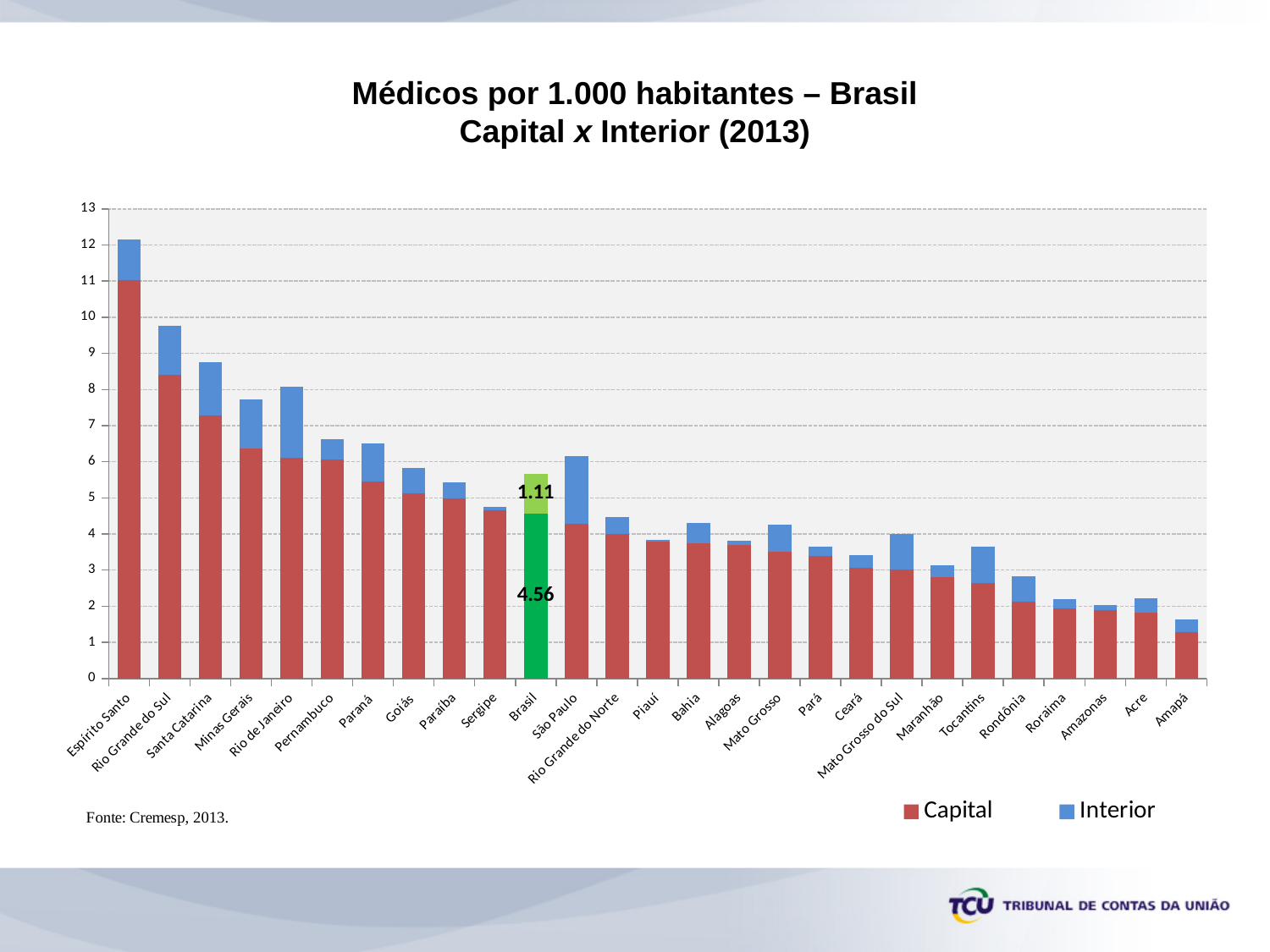
What is the Capital value for Brasil? 4.56 What is the Interior value for Brasil? 1.11 Is the total value for Amapá greater or less than 2? less How many series does the legend list? 2 For Brasil, which is larger, the Capital value or the Interior value? Capital What is the total height of the stacked bar for Brasil? 5.67 What kind of chart is shown on the slide? Stacked bar chart What is the difference between the Capital and Interior values for Brasil? 3.45 Is the Capital value for Espírito Santo greater or less than 10? greater Which category has the highest total bar? Espírito Santo Which category has the lowest total bar? Amapá How many categories are shown on the x axis? 27